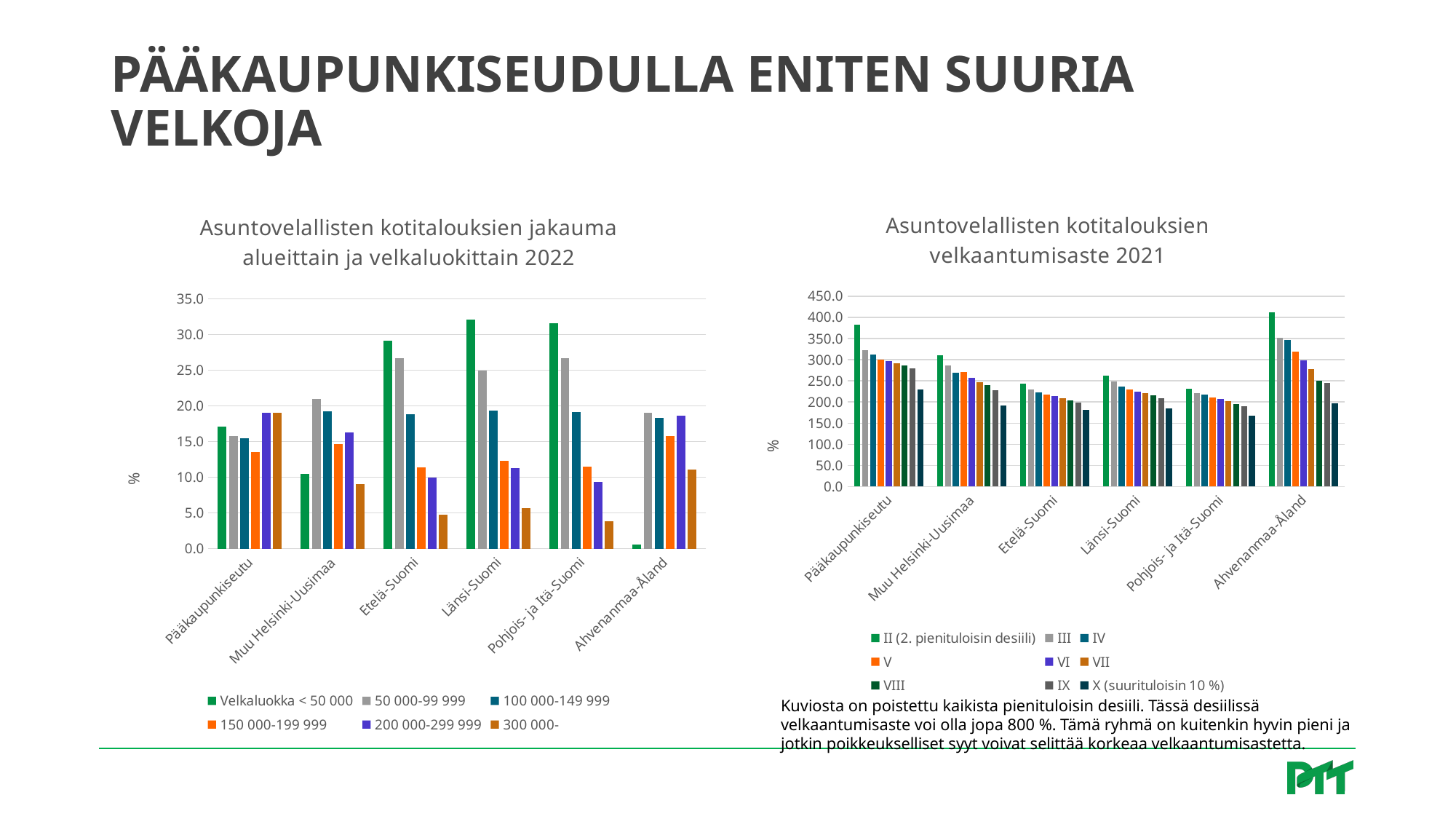
In the right chart, 'Asuntovelallisten kotitalouksien velkaantumisaste 2021', which is larger for series 'II (2. pienituloisin desiili)': Pääkaupunkiseutu or Etelä-Suomi? Pääkaupunkiseutu How many series does the legend of the left chart, 'Asuntovelallisten kotitalouksien jakauma alueittain ja velkaluokittain 2022', list? 6 In the right chart, 'Asuntovelallisten kotitalouksien velkaantumisaste 2021', is the value for 'X (suurituloisin 10 %)' in Pääkaupunkiseutu greater or less than 250.0? less In the right chart, 'Asuntovelallisten kotitalouksien velkaantumisaste 2021', which region has the highest value for series 'II (2. pienituloisin desiili)'? Ahvenanmaa-Åland In the left chart, 'Asuntovelallisten kotitalouksien jakauma alueittain ja velkaluokittain 2022', which region has the lowest value for 'Velkaluokka < 50 000'? Ahvenanmaa-Åland How many regions are shown on the x axis of the left chart, 'Asuntovelallisten kotitalouksien jakauma alueittain ja velkaluokittain 2022'? 6 In the left chart, 'Asuntovelallisten kotitalouksien jakauma alueittain ja velkaluokittain 2022', which region has the highest value for '300 000-'? Pääkaupunkiseutu In the left chart, 'Asuntovelallisten kotitalouksien jakauma alueittain ja velkaluokittain 2022', is the value for 'Velkaluokka < 50 000' in Etelä-Suomi greater or less than 25.0? greater In the left chart, 'Asuntovelallisten kotitalouksien jakauma alueittain ja velkaluokittain 2022', which is larger for Pääkaupunkiseutu: '300 000-' or '150 000-199 999'? 300 000- How many series does the legend of the right chart, 'Asuntovelallisten kotitalouksien velkaantumisaste 2021', list? 9 What type of chart is the left chart, 'Asuntovelallisten kotitalouksien jakauma alueittain ja velkaluokittain 2022'? bar chart In the left chart, 'Asuntovelallisten kotitalouksien jakauma alueittain ja velkaluokittain 2022', is the value for '300 000-' in Pohjois- ja Itä-Suomi greater or less than 5.0? less